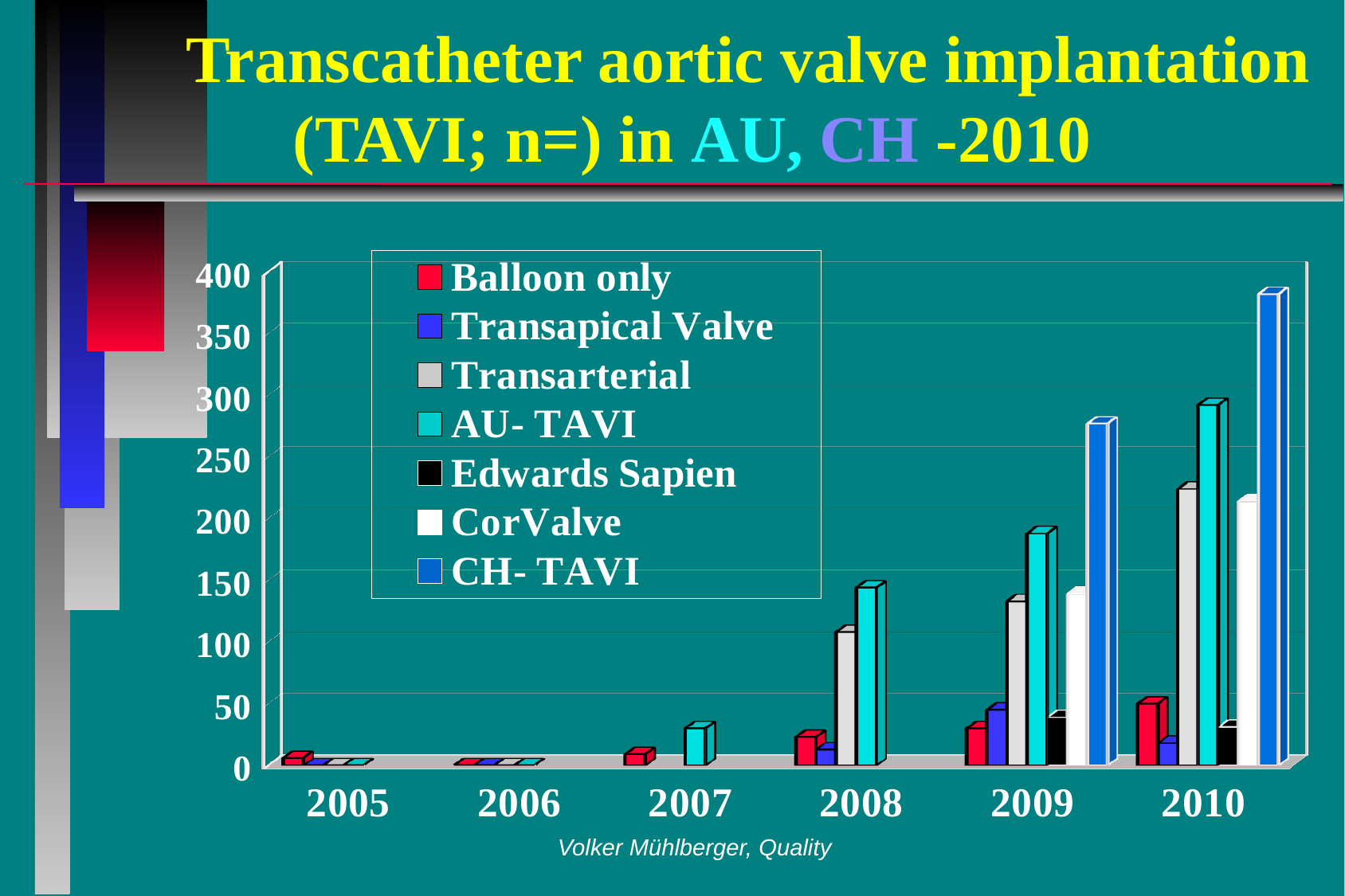
Is the value for AU- TAVI in 2010 greater or less than 250? greater Do the AU- TAVI values rise or fall from 2005 to 2010? rise Is the value for Transarterial in 2009 greater or less than 150? less How many years are shown on the x axis? 6 How many series does the legend list? 7 Is the value for CH- TAVI in 2010 greater or less than 350? greater What kind of chart is shown on the slide? bar chart In which year is the CH- TAVI bar the highest? 2010 What colour represents Balloon only in the legend? red In 2010, which is larger: CH- TAVI or AU- TAVI? CH- TAVI In 2009, which is larger: AU- TAVI or Transarterial? AU- TAVI